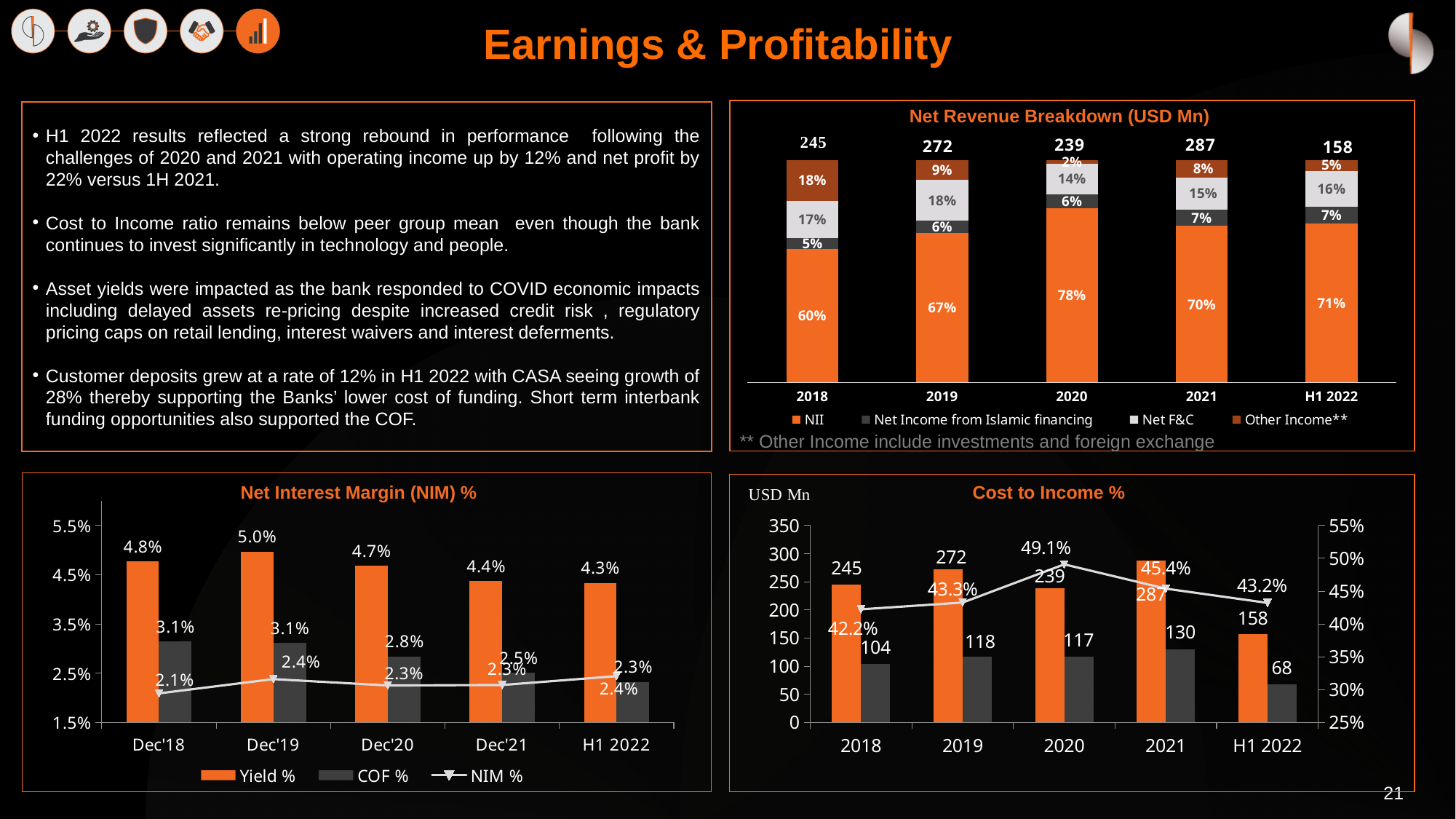
In the Net Revenue Breakdown chart, what share of net revenue did NII account for in 2020? 78% In the Net Interest Margin (NIM) % chart, what is the Yield % for Dec'19? 5.0% In the Net Revenue Breakdown chart, which year has the highest total net revenue? 2021 In the Net Interest Margin (NIM) % chart, what is the NIM % for Dec'18? 2.1% In the Net Interest Margin (NIM) % chart, does Yield % rise or fall from Dec'19 to H1 2022? fall In the Cost to Income % chart, what is the value of the grey bar for H1 2022? 68 In the Cost to Income % chart, which year has the highest cost to income ratio? 2020 In the Net Revenue Breakdown chart, what is the total net revenue shown for 2021? 287 In the Net Revenue Breakdown chart, what is the difference between the total for 2019 and the total for 2020? 33 How many series does the legend of the Net Revenue Breakdown chart list? 4 In the Cost to Income % chart, what is the cost to income ratio for 2020? 49.1% In the Net Interest Margin (NIM) % chart, which period has the lowest COF %? H1 2022